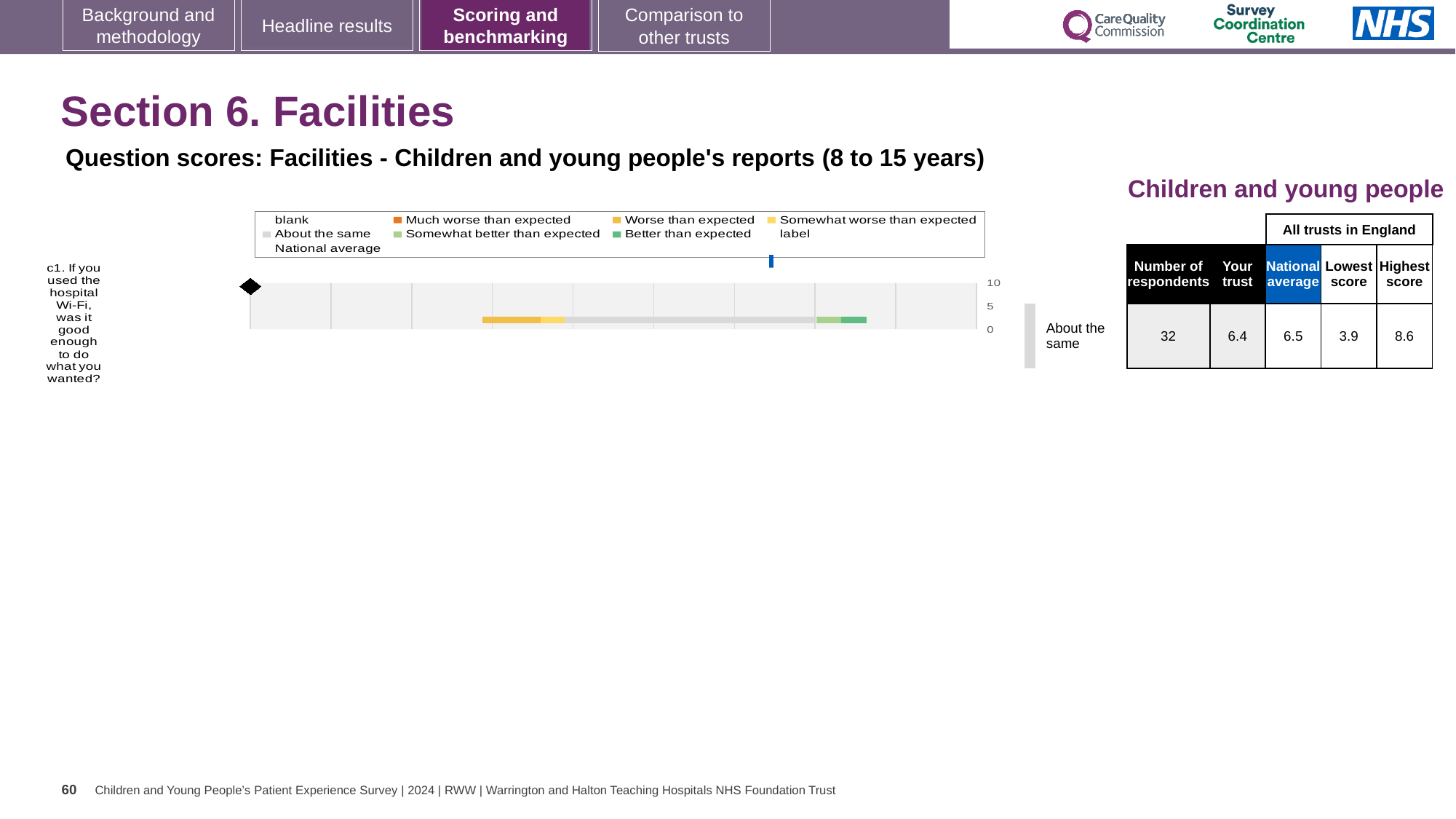
What is the highest value shown on the chart's axis? 10 Which legend entry is shown in dark green? Better than expected According to the table, what is the national average score for the hospital Wi-Fi question? 6.5 What kind of chart is shown on the slide? bar chart According to the table, what is the lowest score among all trusts in England for the hospital Wi-Fi question? 3.9 Which is larger for the hospital Wi-Fi question: the 'Your trust' score or the national average? National average What is the difference between the highest score (8.6) and the lowest score (3.9) in the table? 4.7 How many questions (categories) are plotted in the chart? 1 According to the table, what is the 'Your trust' score for the hospital Wi-Fi question? 6.4 According to the table, how many respondents answered question c1 about the hospital Wi-Fi? 32 According to the table, what is the highest score among all trusts in England for the hospital Wi-Fi question? 8.6 How many entries does the chart legend list? 9